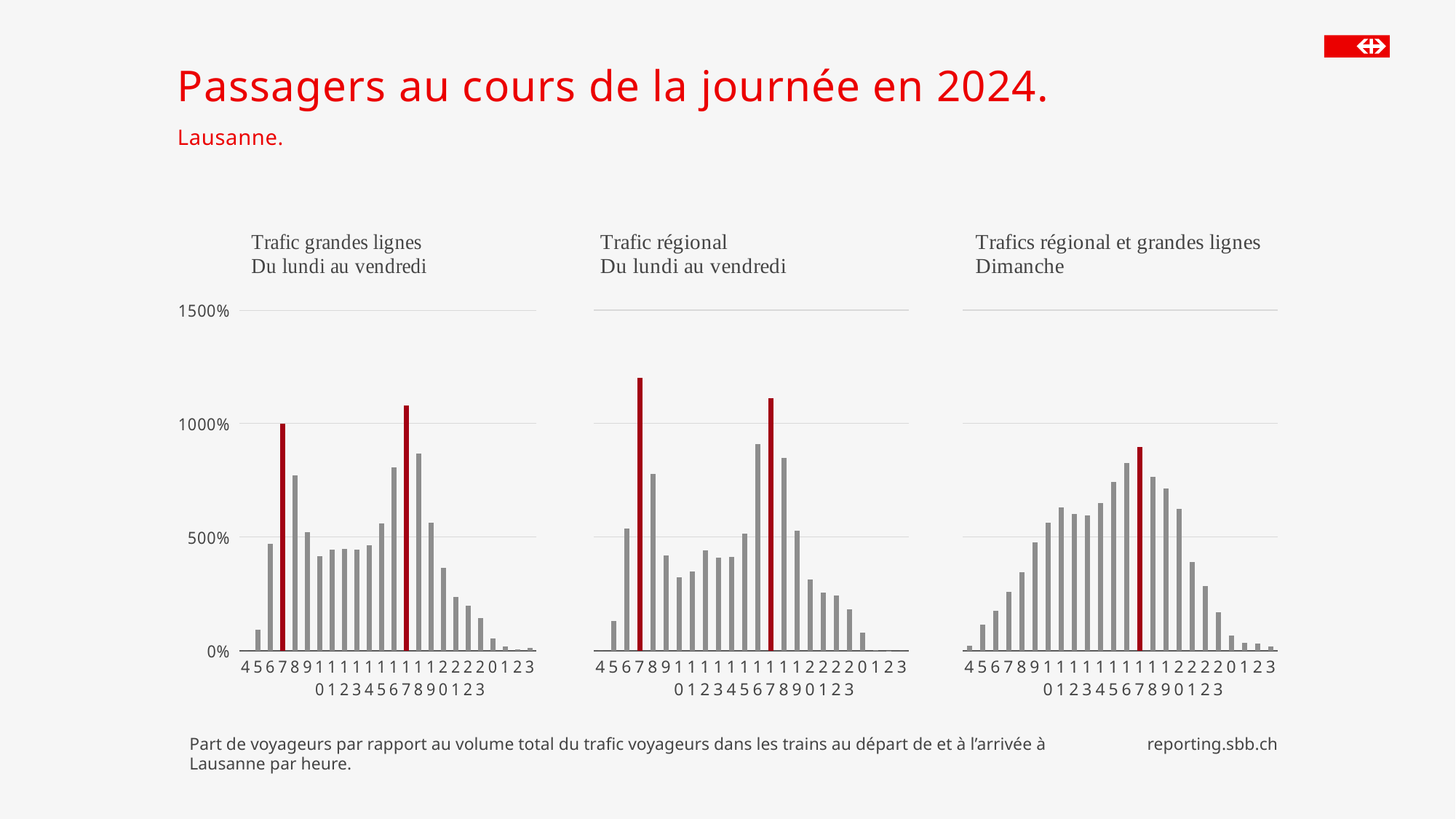
In the 'Trafic régional Du lundi au vendredi' chart, which hour has the highest bar? 7 In the 'Trafics régional et grandes lignes Dimanche' chart, do the values rise or fall from hour 4 to hour 17? Rise How many charts are shown on the slide? 3 In the 'Trafics régional et grandes lignes Dimanche' chart, which hour has the highest bar? 17 Which two hours are highlighted with red bars in each chart? 7 and 17 In the 'Trafic grandes lignes Du lundi au vendredi' chart, which hour has the highest bar? 17 In the 'Trafic régional Du lundi au vendredi' chart, which is larger, the value for hour 7 or the value for hour 17? Hour 7 In the 'Trafic régional Du lundi au vendredi' chart, is the value for hour 7 greater or less than 1000%? greater In the 'Trafic grandes lignes Du lundi au vendredi' chart, is the value for hour 17 greater or less than 1000%? greater In the 'Trafics régional et grandes lignes Dimanche' chart, is the value for hour 17 greater or less than 1000%? less What kind of chart is used for 'Trafic grandes lignes Du lundi au vendredi'? Bar chart How many hour categories are shown on the x axis of the 'Trafic régional Du lundi au vendredi' chart? 24